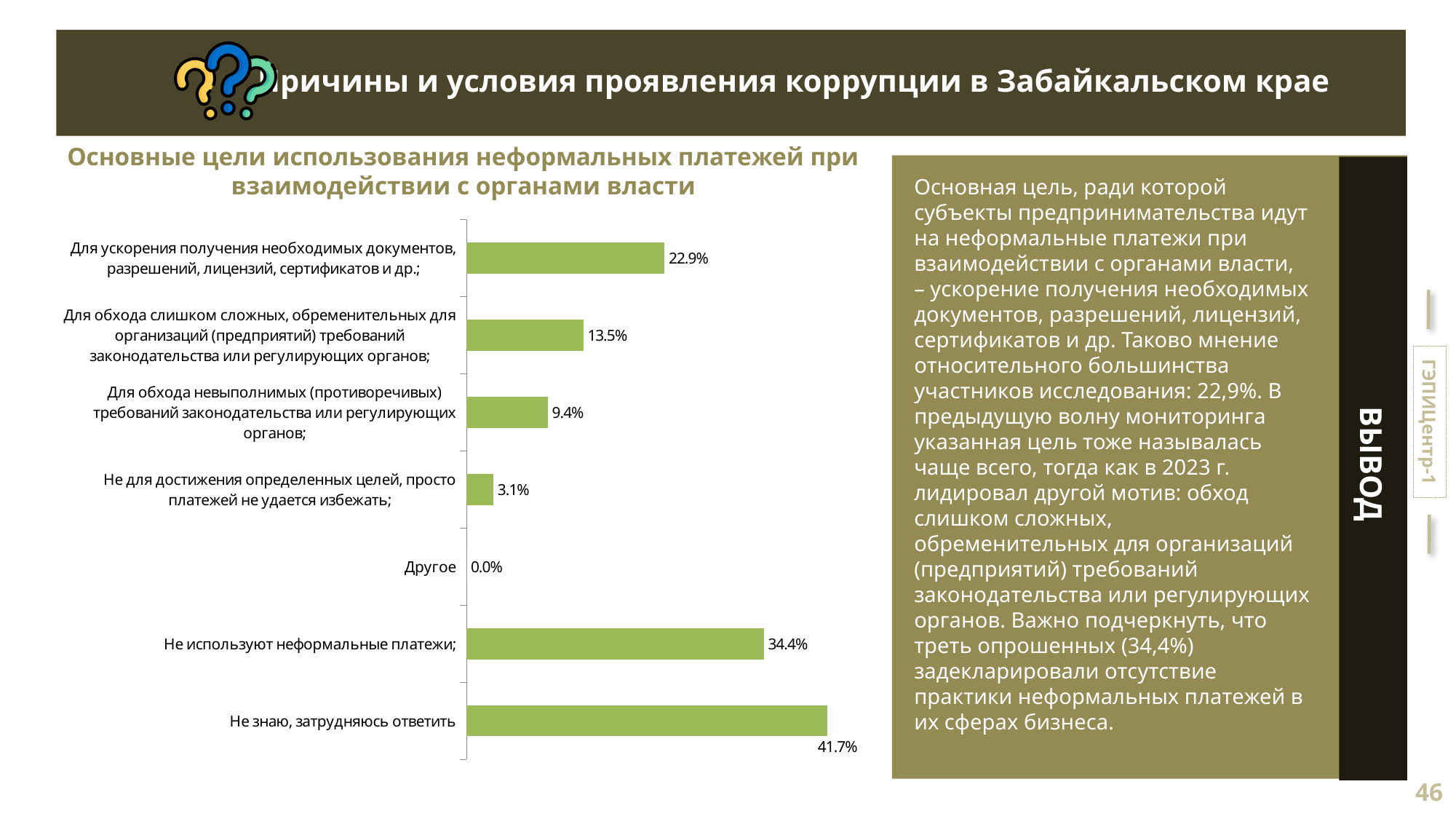
Which is larger: "Для ускорения получения необходимых документов, разрешений, лицензий, сертификатов и др." or "Для обхода слишком сложных, обременительных для организаций (предприятий) требований законодательства или регулирующих органов"? Для ускорения получения необходимых документов, разрешений, лицензий, сертификатов и др. Which category has the highest value? Не знаю, затрудняюсь ответить What is the value for "Не используют неформальные платежи"? 34.4% What is the difference between "Для обхода слишком сложных, обременительных для организаций (предприятий) требований законодательства или регулирующих органов" and "Для обхода невыполнимых (противоречивых) требований законодательства или регулирующих органов"? 4.1% What is the value for "Не знаю, затрудняюсь ответить"? 41.7% How many categories are shown in the chart? 7 What is the title of the chart? Основные цели использования неформальных платежей при взаимодействии с органами власти What is the value for "Для ускорения получения необходимых документов, разрешений, лицензий, сертификатов и др."? 22.9% Which category has the lowest value? Другое What is the value for "Не для достижения определенных целей, просто платежей не удается избежать"? 3.1% What type of chart is shown on the slide? bar chart What is the difference between "Не знаю, затрудняюсь ответить" and "Не используют неформальные платежи"? 7.3%